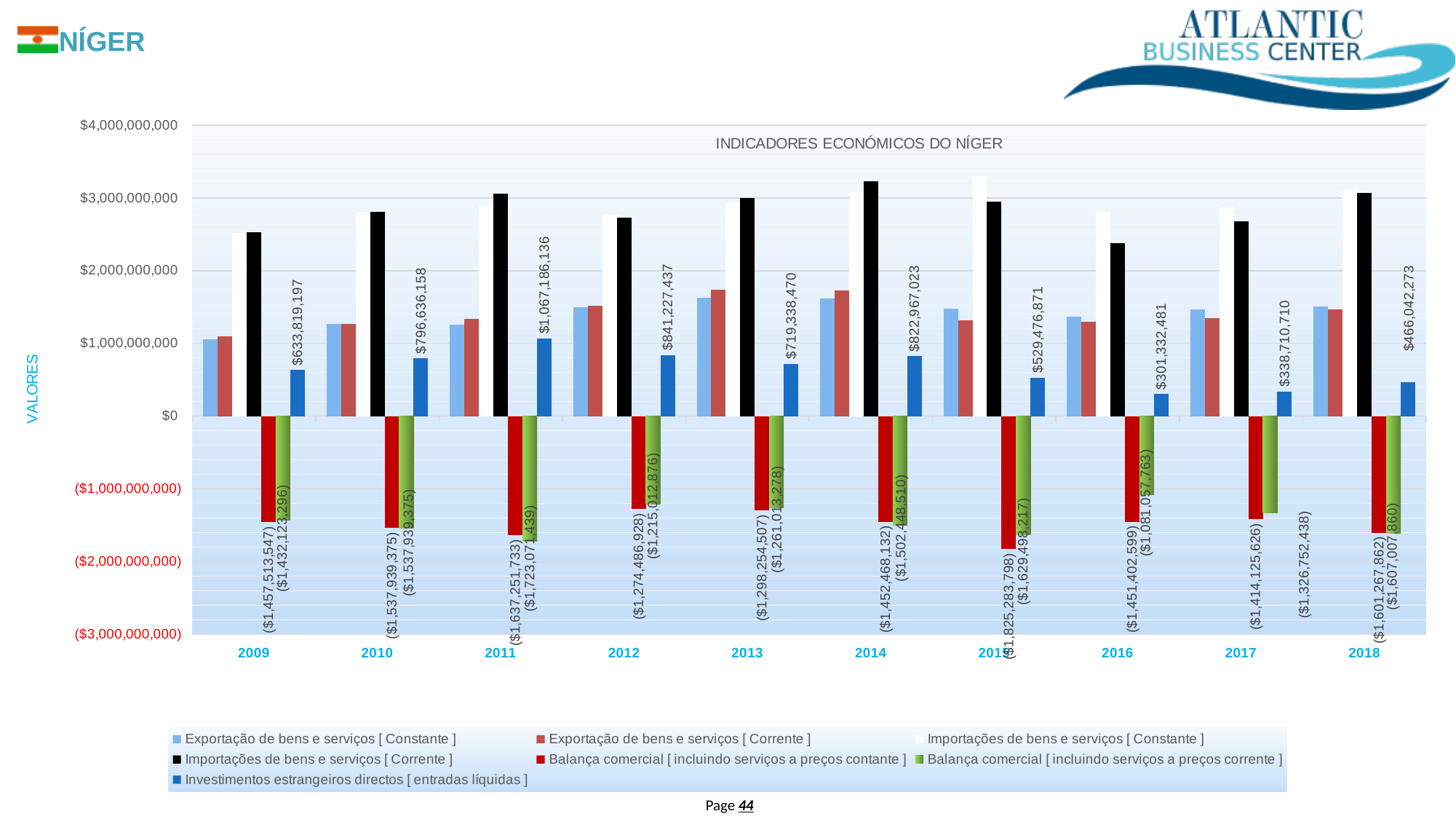
How many series does the chart legend list? 7 What type of chart is shown on the slide? Bar chart Is the value for Importações de bens e serviços [Corrente] in 2014 greater or less than $3,000,000,000? greater What is the difference between Investimentos estrangeiros directos [entradas líquidas] in 2011 and in 2010? $270,549,978 What is the value of Investimentos estrangeiros directos [entradas líquidas] in 2016? $301,332,481 In which year is Investimentos estrangeiros directos [entradas líquidas] highest? 2011 Which year has the larger value for Investimentos estrangeiros directos [entradas líquidas], 2012 or 2013? 2012 What is the title of the chart? INDICADORES ECONÓMICOS DO NÍGER Does Investimentos estrangeiros directos [entradas líquidas] rise or fall from 2014 to 2016? fall In which year is Investimentos estrangeiros directos [entradas líquidas] lowest? 2016 How many years are shown on the x axis of the chart? 10 What is the value of Investimentos estrangeiros directos [entradas líquidas] in 2011? $1,067,186,136